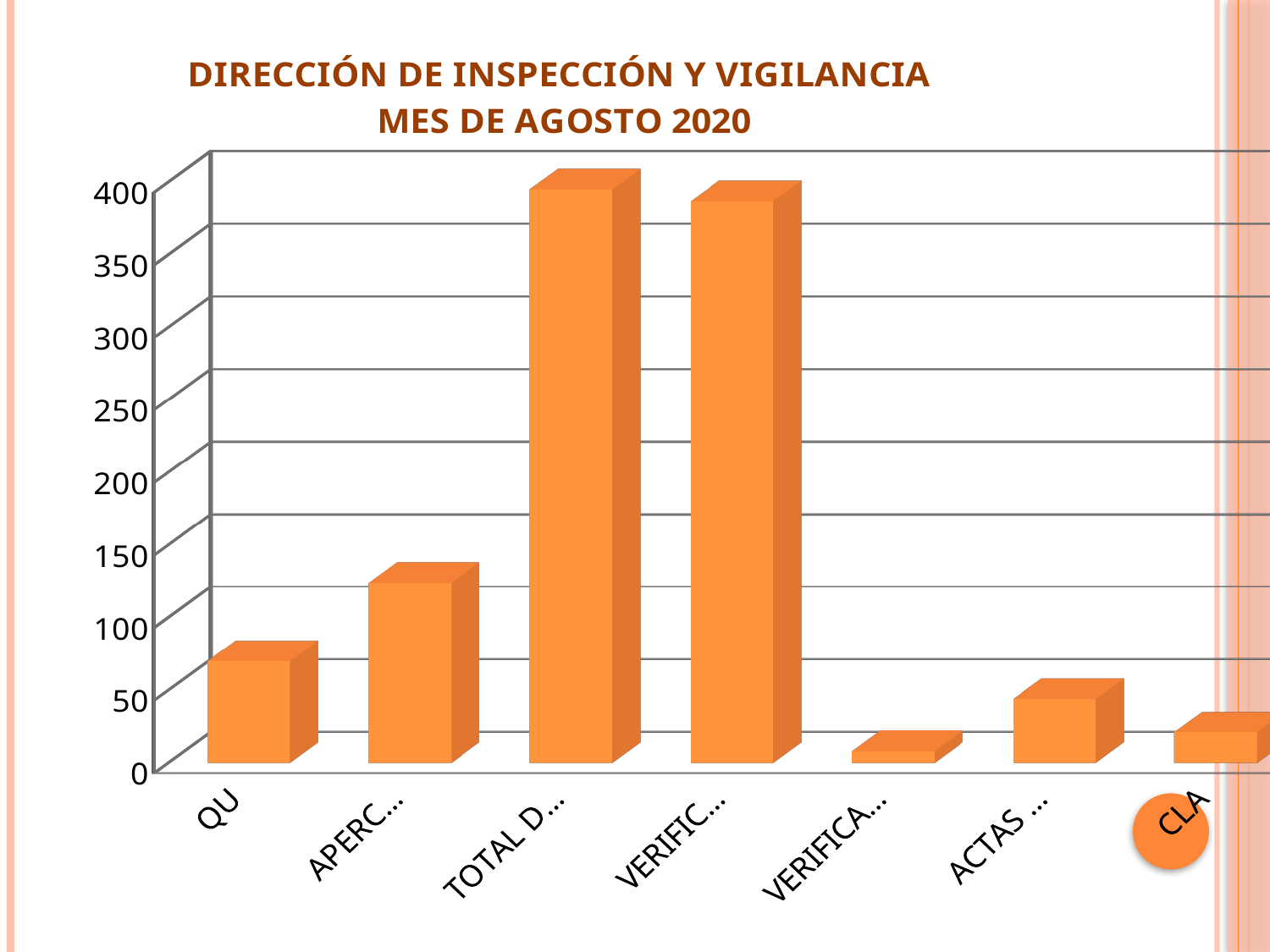
Which has the larger value, QU or APERC...? APERC... Is the value for QU greater or less than 100? less What kind of chart is shown on the slide? Bar chart Is the value for CLA greater or less than 50? less What colour are the bars in the chart? Orange Is the value for TOTAL D... greater or less than 350? greater How many bars (categories) does the chart show? 7 Which has the larger value, QU or ACTAS ...? QU Which category has the lowest value? VERIFICA... (fifth bar) What is the title of the chart? DIRECCIÓN DE INSPECCIÓN Y VIGILANCIA MES DE AGOSTO 2020